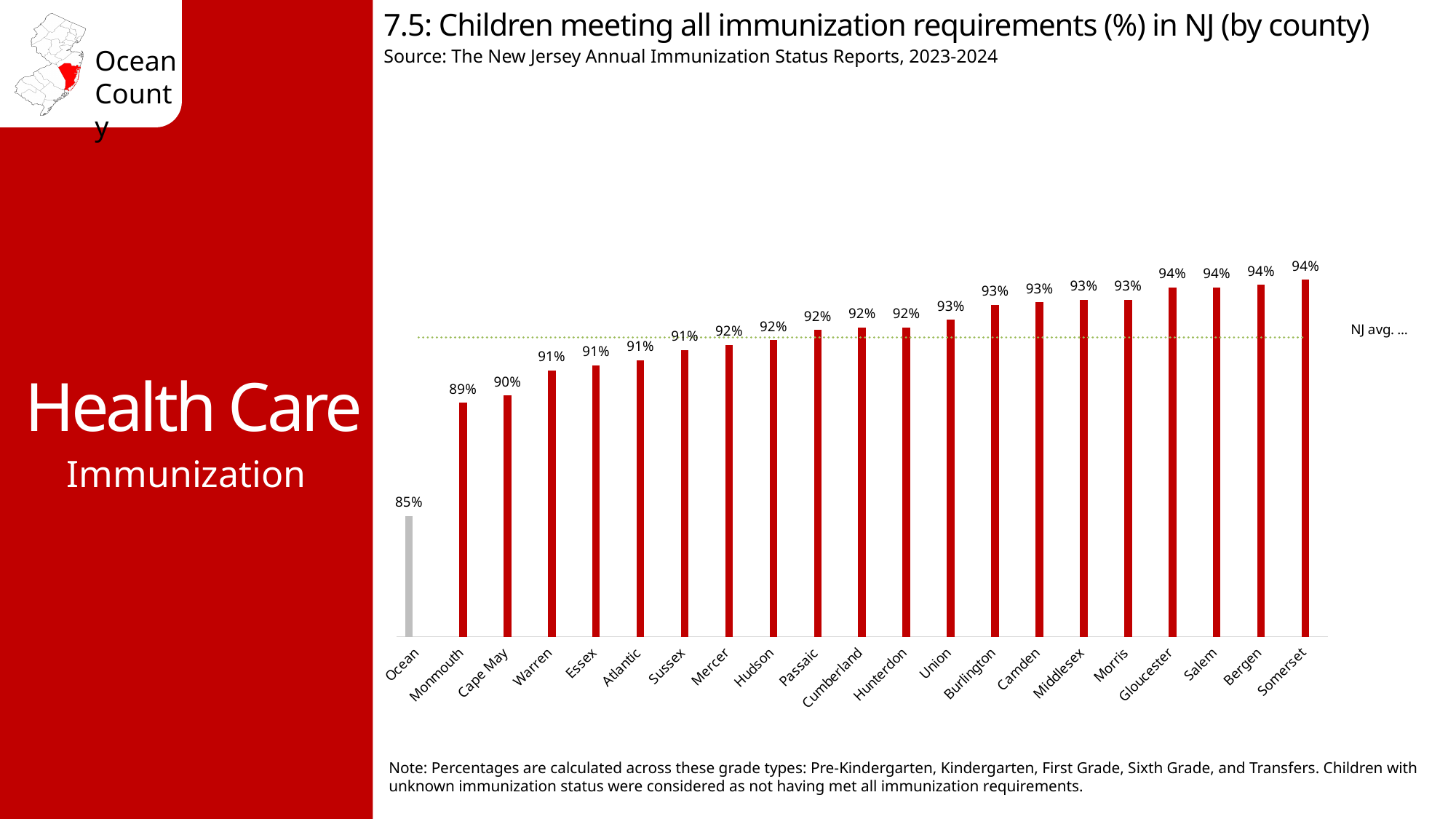
What is the difference in percentage points between Monmouth and Ocean? 4 percentage points What is the difference in percentage points between Somerset and Ocean? 9 percentage points What is the value shown for Union County? 93% What is the value shown for Somerset County? 94% Which has a higher value, Ocean or Cape May? Cape May What kind of chart is shown on the slide? Bar chart How many counties are shown on the chart? 21 What is the value shown for Monmouth County? 89% Which county has the lowest percentage of children meeting all immunization requirements? Ocean Do the values generally rise or fall from left to right across the counties? Rise What percentage of children in Ocean County meet all immunization requirements? 85% What is the value shown for Cape May County? 90%